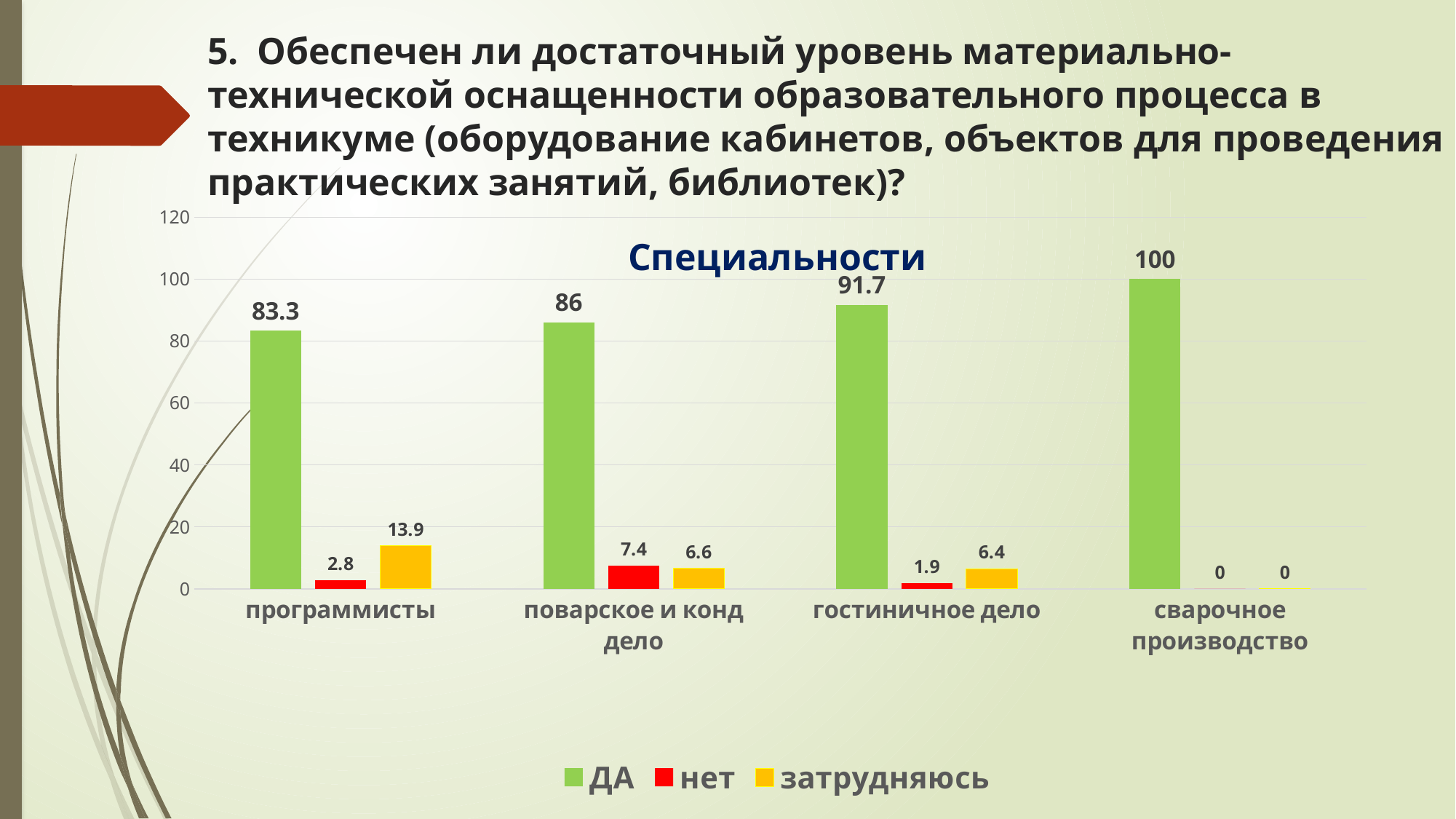
Which category has the highest ДА value? сварочное производство What is the title of the chart? Специальности Which category has the lowest ДА value? программисты Is the ДА value for поварское и конд дело greater or less than 80? greater What is the value of затрудняюсь for поварское и конд дело? 6.6 What is the value of нет for гостиничное дело? 1.9 How many series does the legend list? 3 What is the value of ДА for программисты? 83.3 How many categories are shown on the x axis? 4 What kind of chart is shown? bar chart What is the difference between the ДА values for гостиничное дело and поварское и конд дело? 5.7 Which is larger for программисты: нет or затрудняюсь? затрудняюсь